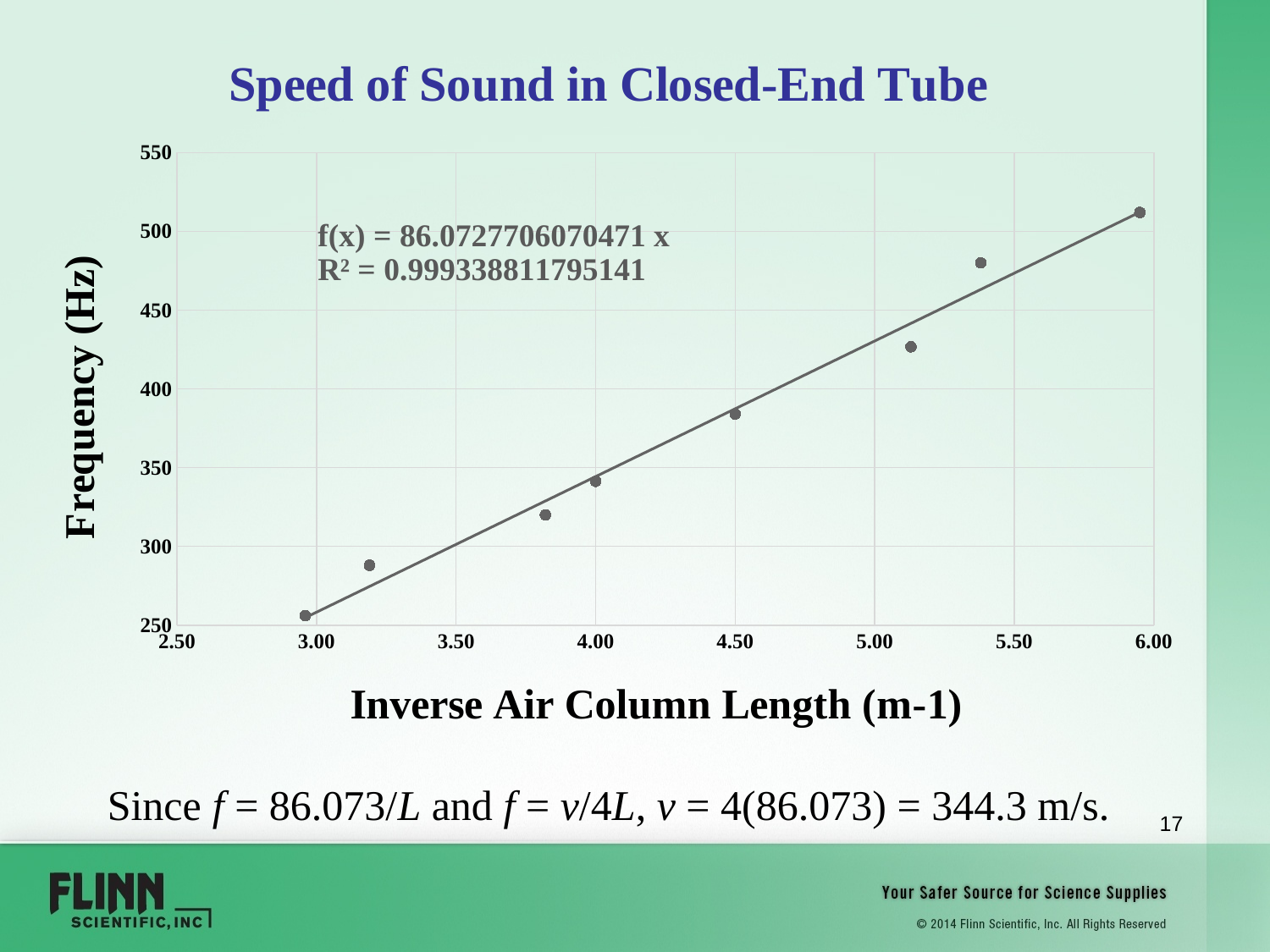
What is the label of the y axis? Frequency (Hz) Is the frequency of the data point with the largest inverse air column length greater or less than 500? greater What kind of chart is shown on the slide? scatter chart Which data point has the highest frequency: the one at the largest inverse air column length or the one at the smallest? the one at the largest inverse air column length What is the title of the chart? Speed of Sound in Closed-End Tube Is the frequency of the data point at an inverse air column length of about 5.13 greater or less than 400? greater Is the frequency of the data point at an inverse air column length of about 4.50 greater or less than 350? greater How many data points are plotted on the chart? 8 Do the frequency values rise or fall as the inverse air column length increases? rise